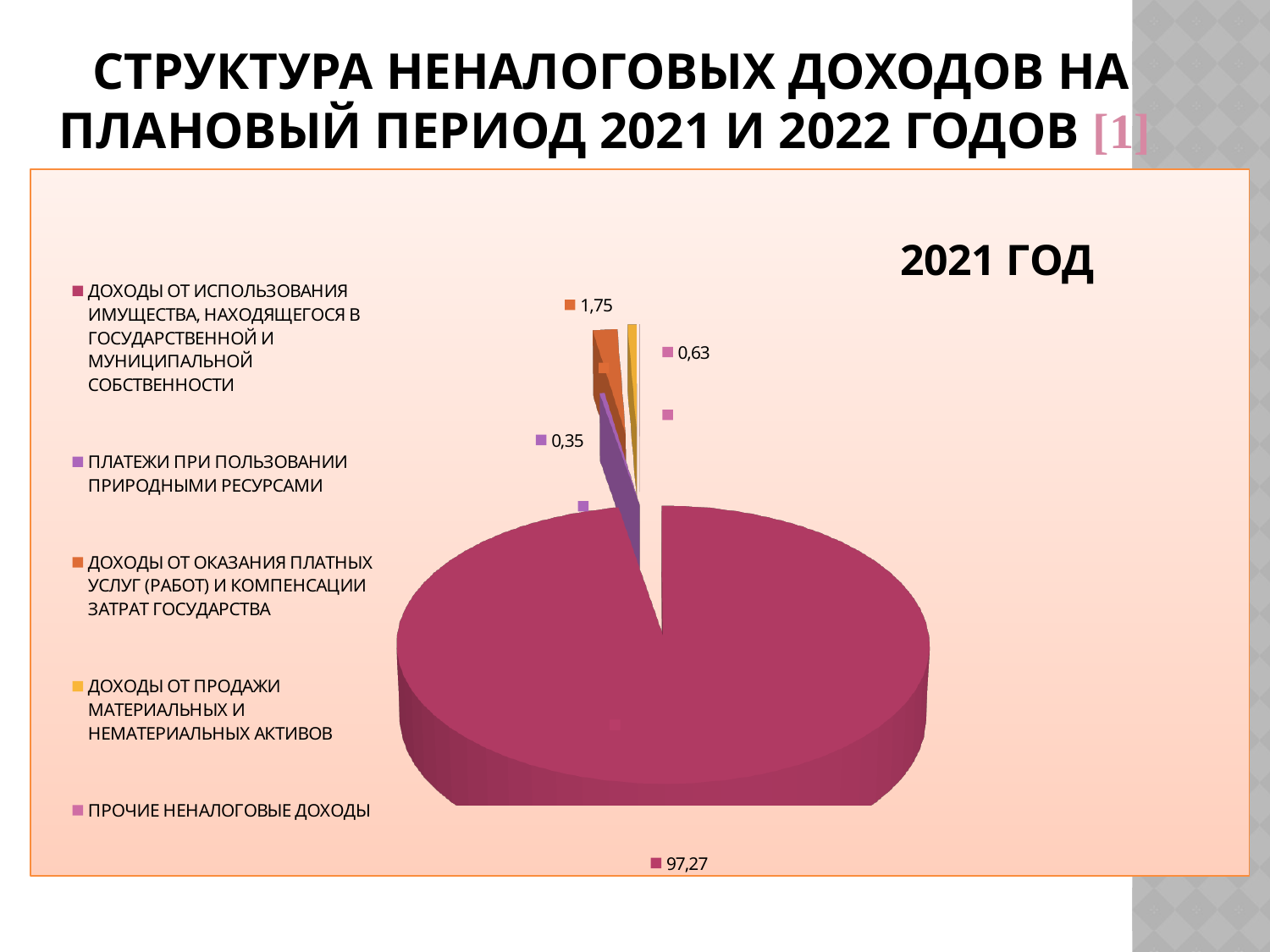
What value is labelled for ДОХОДЫ ОТ ОКАЗАНИЯ ПЛАТНЫХ УСЛУГ (РАБОТ) И КОМПЕНСАЦИИ ЗАТРАТ ГОСУДАРСТВА? 1,75 What is the difference between the labelled values 1,75 and 0,35? 1,40 How many categories does the legend of the pie chart list? 5 Which is larger: the value for ДОХОДЫ ОТ ОКАЗАНИЯ ПЛАТНЫХ УСЛУГ (РАБОТ) И КОМПЕНСАЦИИ ЗАТРАТ ГОСУДАРСТВА or the value for ПЛАТЕЖИ ПРИ ПОЛЬЗОВАНИИ ПРИРОДНЫМИ РЕСУРСАМИ? ДОХОДЫ ОТ ОКАЗАНИЯ ПЛАТНЫХ УСЛУГ (РАБОТ) И КОМПЕНСАЦИИ ЗАТРАТ ГОСУДАРСТВА What value is labelled on the largest slice of the pie chart? 97,27 Which category has the largest slice of the pie chart? ДОХОДЫ ОТ ИСПОЛЬЗОВАНИЯ ИМУЩЕСТВА, НАХОДЯЩЕГОСЯ В ГОСУДАРСТВЕННОЙ И МУНИЦИПАЛЬНОЙ СОБСТВЕННОСТИ What colour is the largest slice of the pie chart? dark pink (magenta) What value is labelled for ПЛАТЕЖИ ПРИ ПОЛЬЗОВАНИИ ПРИРОДНЫМИ РЕСУРСАМИ? 0,35 What is the title shown above the pie chart? 2021 ГОД What kind of chart is shown on the slide? pie chart What is the difference between the labelled value 97,27 and the labelled value 1,75? 95,52